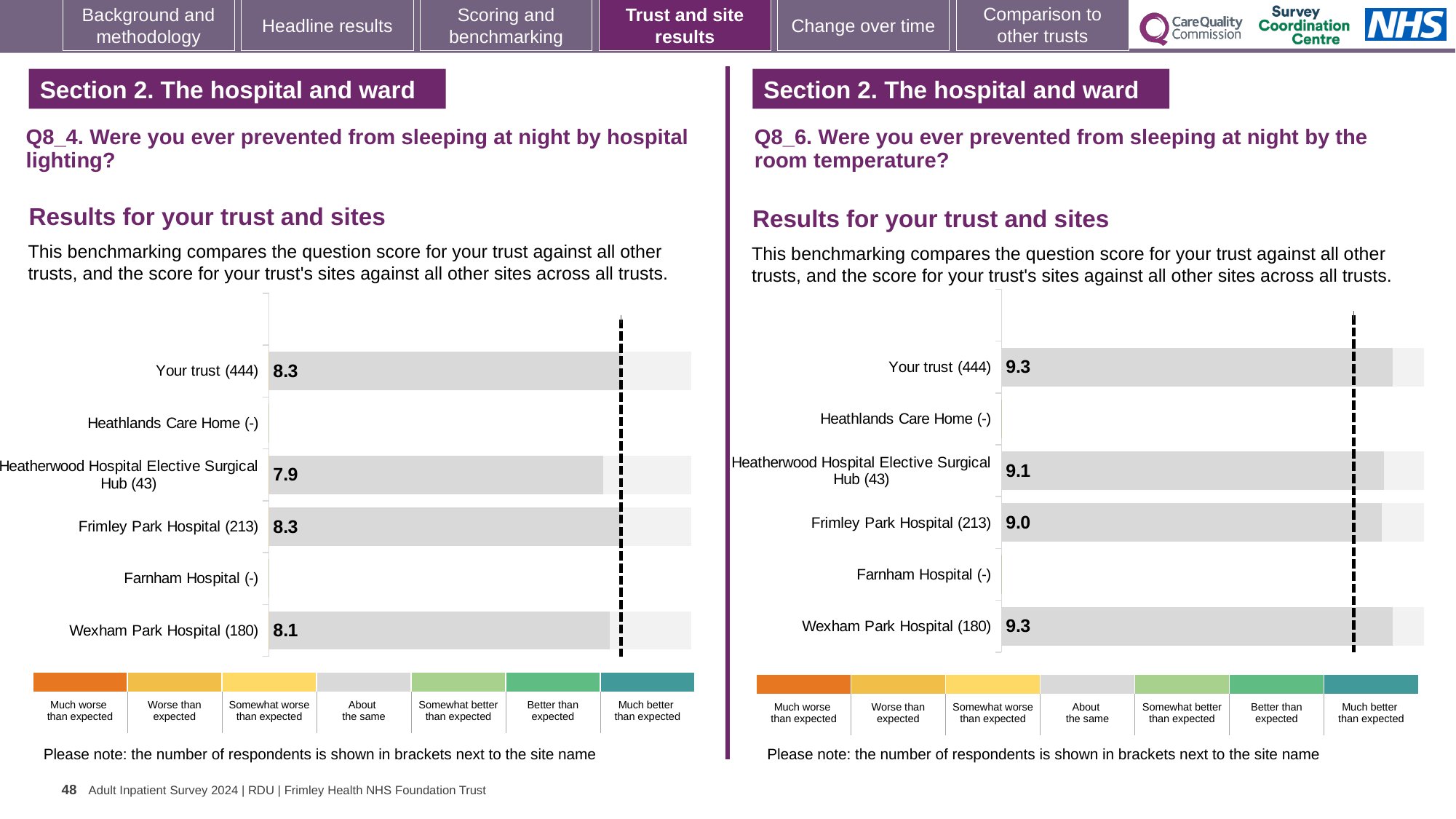
In the Q8_6 room temperature chart, which site has the lowest score? Frimley Park Hospital (213) In the Q8_4 hospital lighting chart, what is the difference between the scores for Frimley Park Hospital (213) and Wexham Park Hospital (180)? 0.2 In the Q8_6 room temperature chart, what is the difference between the scores for Your trust (444) and Heatherwood Hospital Elective Surgical Hub (43)? 0.2 How many site rows (including Your trust) are listed in the Q8_4 hospital lighting chart? 6 In the Q8_6 room temperature chart, which has the higher score: Heatherwood Hospital Elective Surgical Hub (43) or Frimley Park Hospital (213)? Heatherwood Hospital Elective Surgical Hub (43) What type of chart is used for the Q8_6 room temperature results? Bar chart In the Q8_4 hospital lighting chart, what is the score for Heatherwood Hospital Elective Surgical Hub (43)? 7.9 In the Q8_4 hospital lighting chart, what is the score for Your trust (444)? 8.3 In the Q8_6 room temperature chart, what is the score for Frimley Park Hospital (213)? 9.0 In the Q8_6 room temperature chart, what is the score for Wexham Park Hospital (180)? 9.3 In the Q8_4 hospital lighting chart, which site has the lowest score? Heatherwood Hospital Elective Surgical Hub (43) In the Q8_4 hospital lighting chart, what is the score for Wexham Park Hospital (180)? 8.1